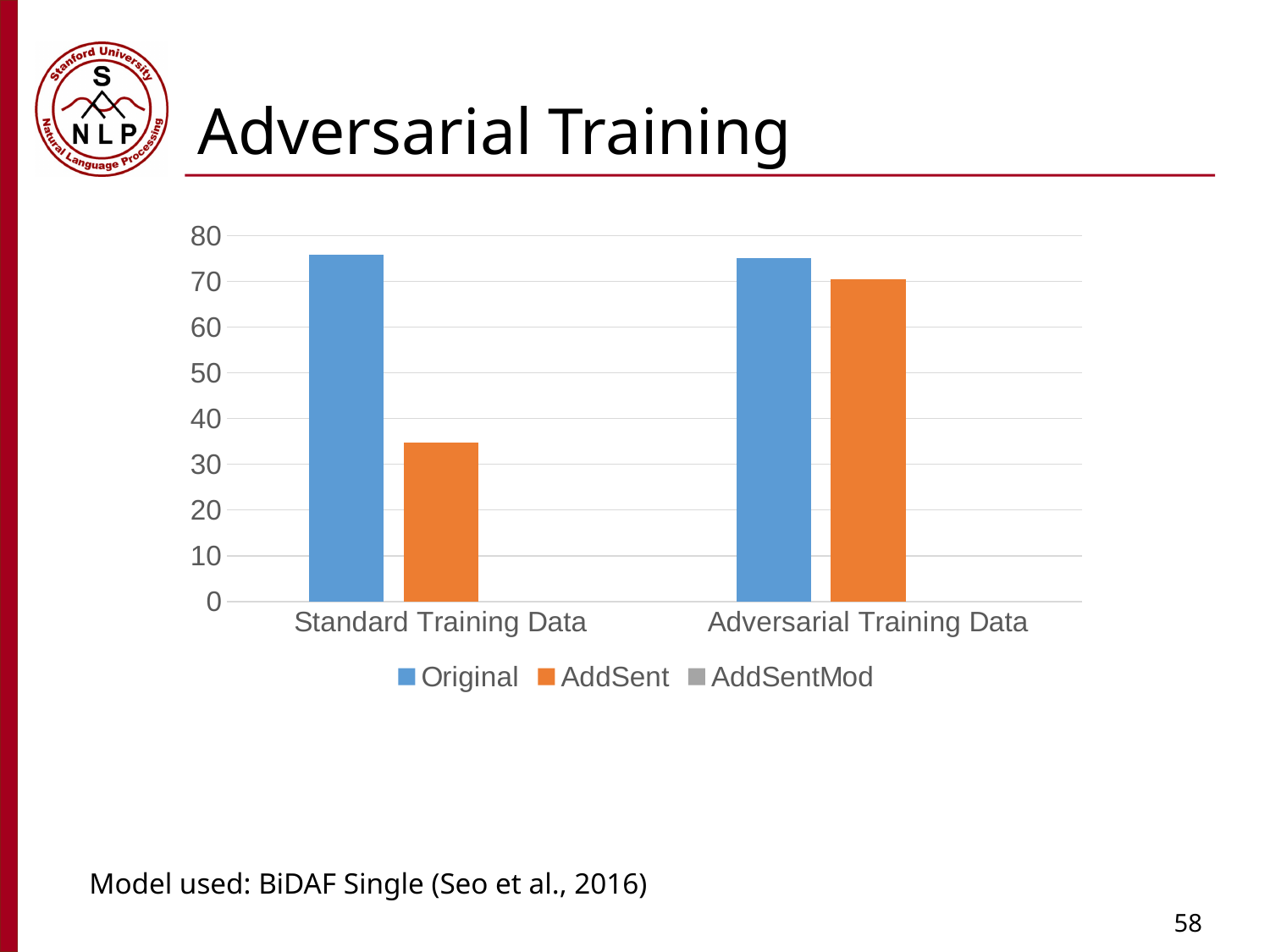
Does the AddSent value rise or fall from Standard Training Data to Adversarial Training Data? rise What colour are the AddSent bars? orange Is the AddSent value for Standard Training Data greater or less than 40? less Which category has the larger AddSent value, Standard Training Data or Adversarial Training Data? Adversarial Training Data For Standard Training Data, which series has the higher value, Original or AddSent? Original What kind of chart is shown on the slide? bar chart Is the Original value for Standard Training Data greater or less than 70? greater Is the Original value for Adversarial Training Data greater or less than 80? less Which bar is the lowest in the chart? AddSent for Standard Training Data How many series does the legend list? 3 How many categories are shown on the x axis? 2